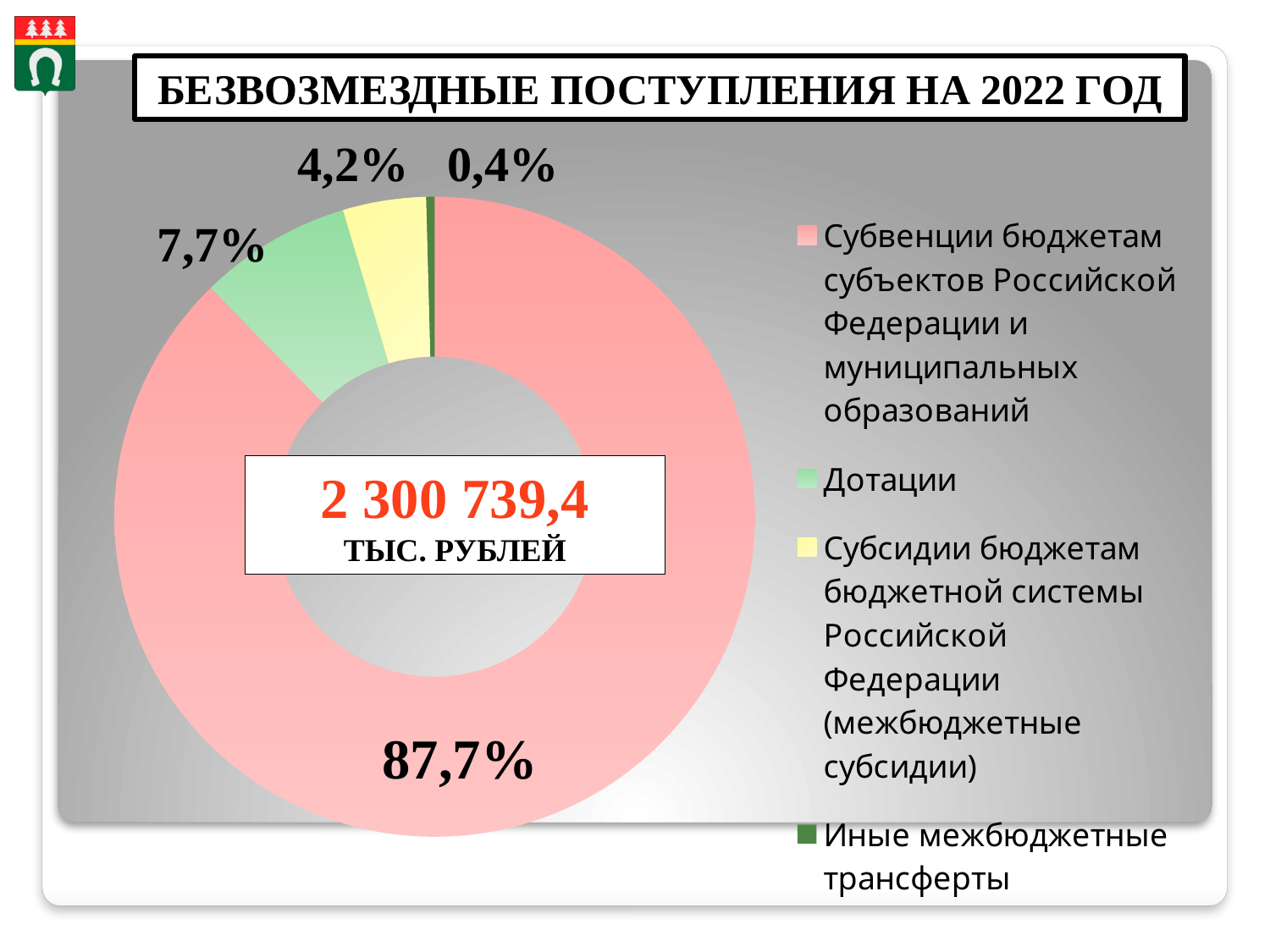
What is the difference in percentage points between the Дотации slice and the Субсидии slice? 3,5 What kind of chart is shown on the slide? Doughnut (pie) chart Which category has the smallest slice in the chart? Иные межбюджетные трансферты What share of the chart does the slice for Дотации represent? 7,7% What share of the chart does the slice for Субвенции бюджетам субъектов Российской Федерации и муниципальных образований represent? 87,7% Which category has the largest slice in the chart? Субвенции бюджетам субъектов Российской Федерации и муниципальных образований What is the title of the chart? БЕЗВОЗМЕЗДНЫЕ ПОСТУПЛЕНИЯ НА 2022 ГОД What total amount is shown in the centre of the chart? 2 300 739,4 тыс. рублей What share of the chart does the slice for Иные межбюджетные трансферты represent? 0,4% How many categories are shown in the chart? 4 Which is larger: the share for Дотации or the share for Иные межбюджетные трансферты? Дотации